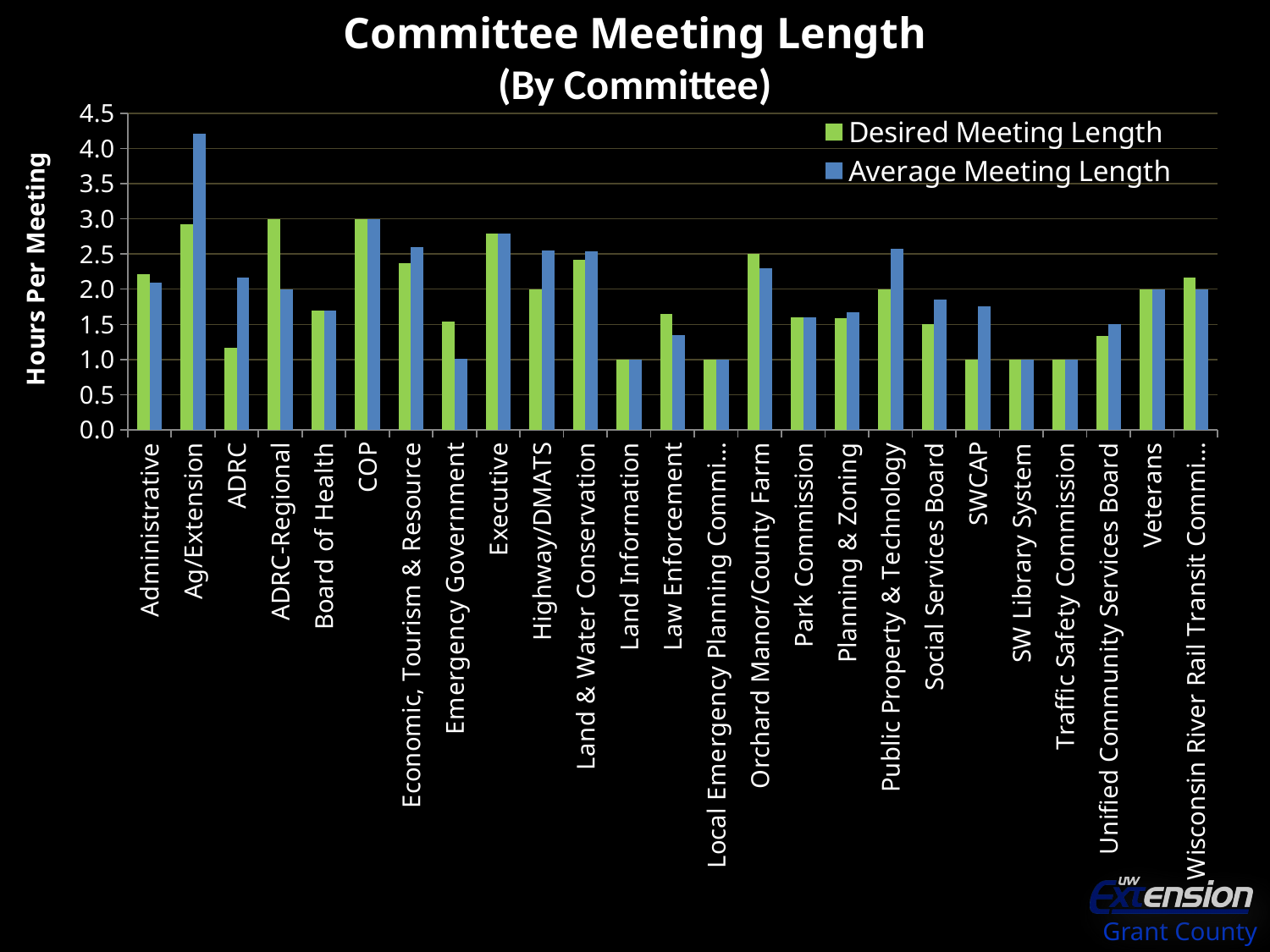
For Public Property & Technology, which is larger: the Desired Meeting Length or the Average Meeting Length? Average Meeting Length What is the Average Meeting Length for Veterans? 2.0 How many series does the legend list? 2 What is the Average Meeting Length for Land Information? 1.0 Which committee has the highest Average Meeting Length? Ag/Extension How many committees are shown on the x axis? 25 What is the Desired Meeting Length for COP? 3.0 What is the label on the y axis? Hours Per Meeting Is the Average Meeting Length for Ag/Extension greater or less than 4.0? greater For Emergency Government, which is larger: the Desired Meeting Length or the Average Meeting Length? Desired Meeting Length What type of chart is shown on the slide? bar chart Is the Desired Meeting Length for Board of Health greater or less than 2.0? less